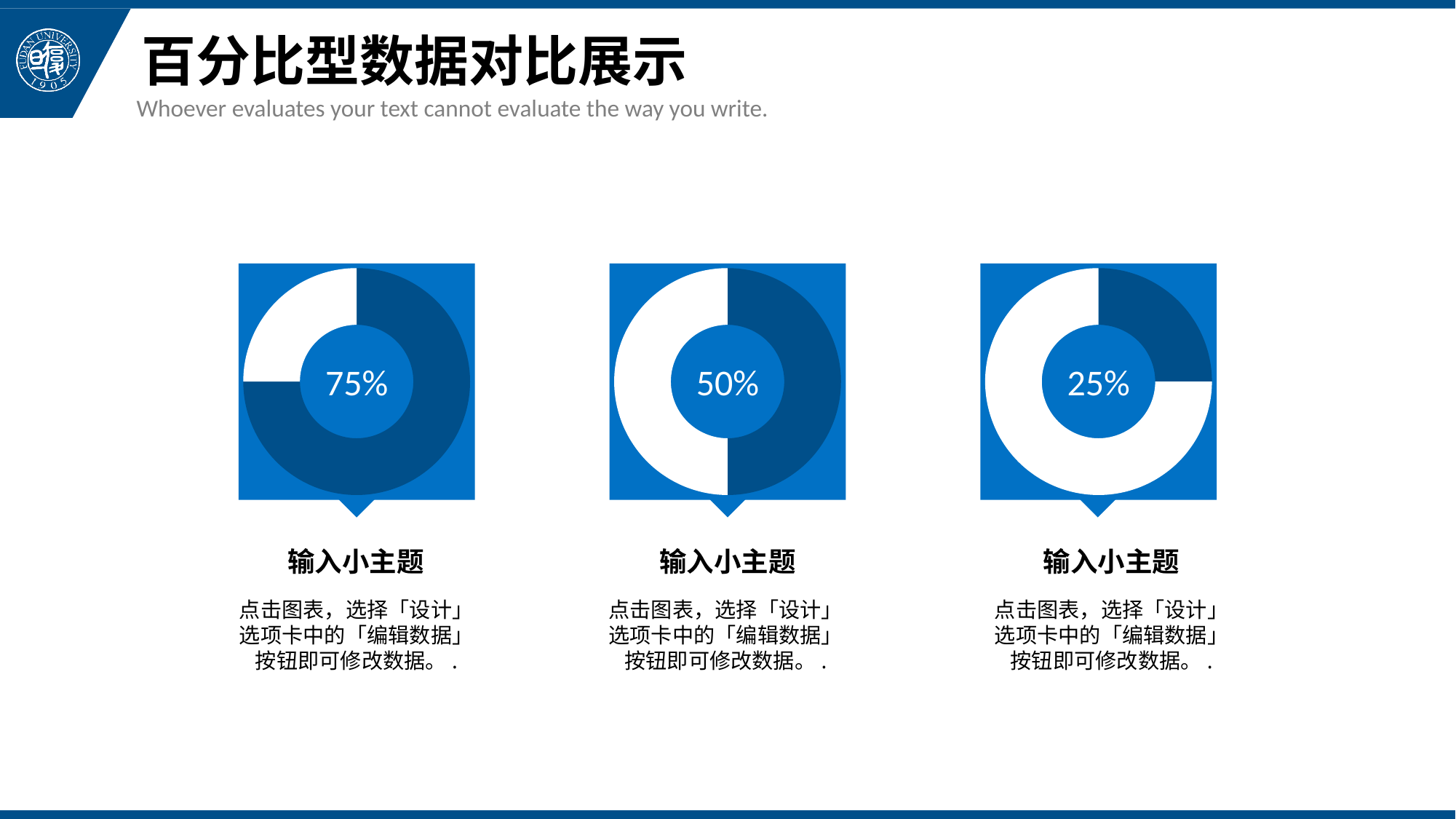
What percentage is shown in the centre of the left doughnut chart? 75% Which shows a larger percentage, the middle doughnut chart or the right doughnut chart? middle What percentage is shown in the centre of the middle doughnut chart? 50% What is the difference between the percentage in the left doughnut chart and the percentage in the middle doughnut chart? 25% What percentage is shown in the centre of the right doughnut chart? 25% What is the title of the slide containing the three doughnut charts? 百分比型数据对比展示 What is the difference between the percentage in the left doughnut chart and the percentage in the right doughnut chart? 50% In the right doughnut chart, what share of the ring is filled with the dark blue segment? 25% What kind of chart is used for each of the three percentage displays on the slide? doughnut chart How many doughnut charts are on the slide? 3 Which of the three doughnut charts shows the highest percentage: left, middle or right? left Which of the three doughnut charts shows the lowest percentage: left, middle or right? right